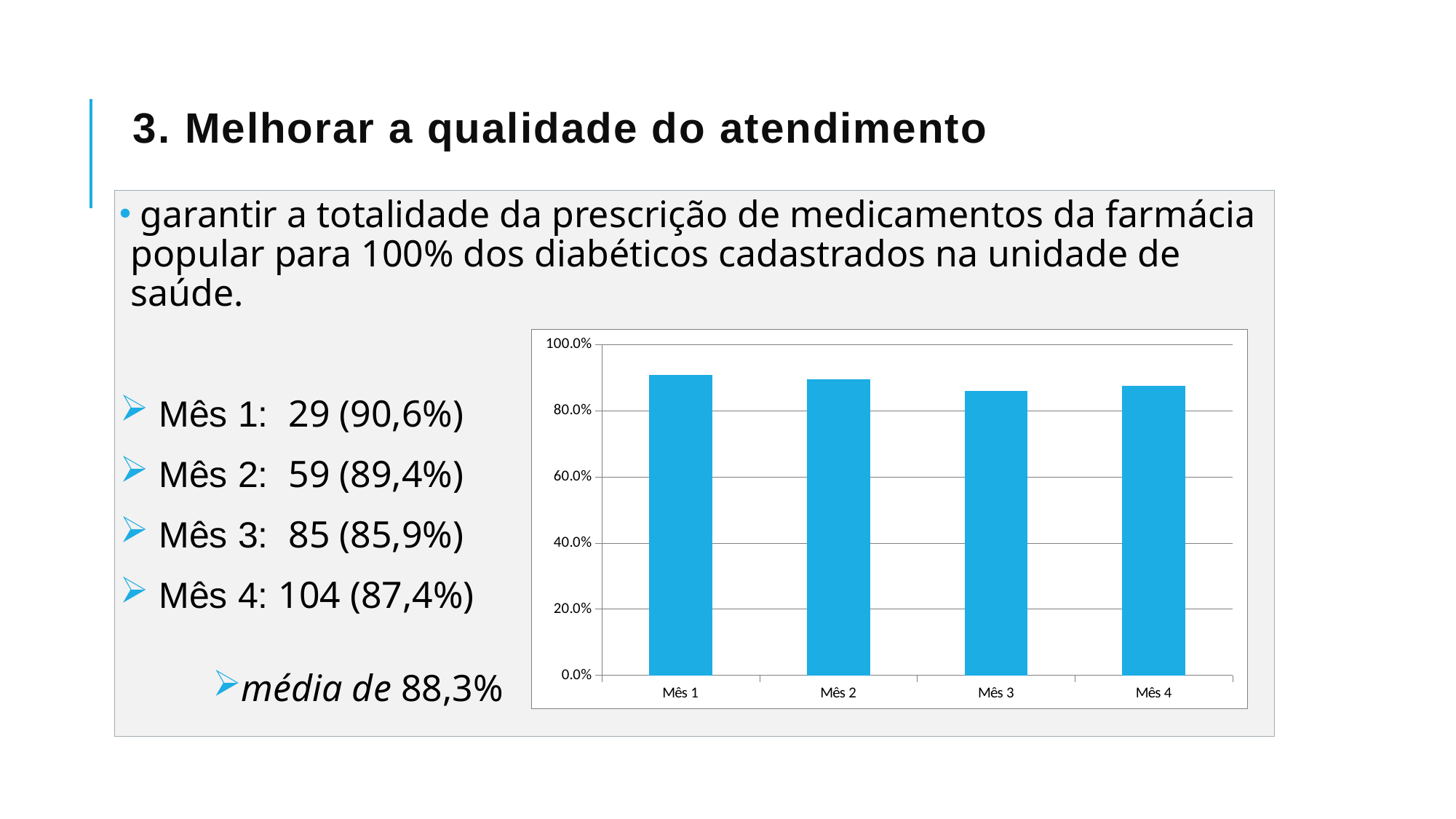
Is the value for Mês 3 greater or less than 80%? greater How many categories (months) are plotted on the x axis of the chart? 4 According to the slide, what percentage is shown for Mês 3? 85,9% Which month has the lowest bar in the chart? Mês 3 Is the value for Mês 4 greater or less than 80%? greater Do the bar values rise or fall from Mês 1 to Mês 3? fall Which month has the highest bar in the chart? Mês 1 Which is larger, the value for Mês 3 or the value for Mês 4? Mês 4 What kind of chart is shown on the slide? bar chart What is the highest tick value shown on the chart's y axis? 100.0% According to the slide, what percentage is shown for Mês 1? 90,6% Is the value for Mês 1 greater or less than 100%? less